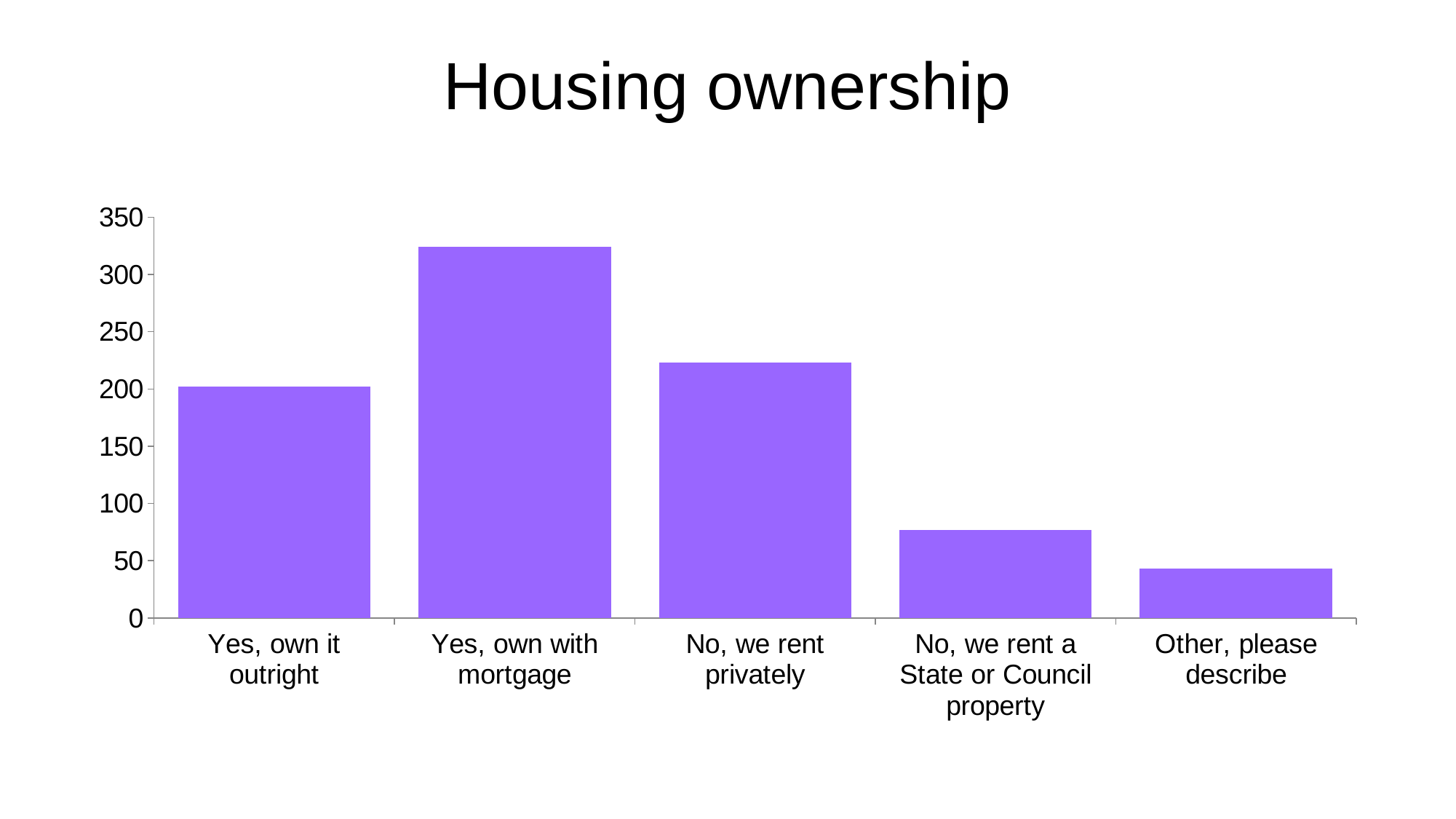
How many categories are shown on the x axis? 5 Is the value for "No, we rent a State or Council property" greater or less than 100? less What is the title of the chart? Housing ownership Is the value for "Other, please describe" greater or less than 50? less Which category has the lowest value? Other, please describe Which is larger, the value for "No, we rent a State or Council property" or the value for "Other, please describe"? No, we rent a State or Council property Is the value for "Yes, own it outright" greater or less than 250? less Which is larger, the value for "Yes, own with mortgage" or the value for "No, we rent privately"? Yes, own with mortgage Which category has the highest value? Yes, own with mortgage What type of chart is shown on the slide? bar chart